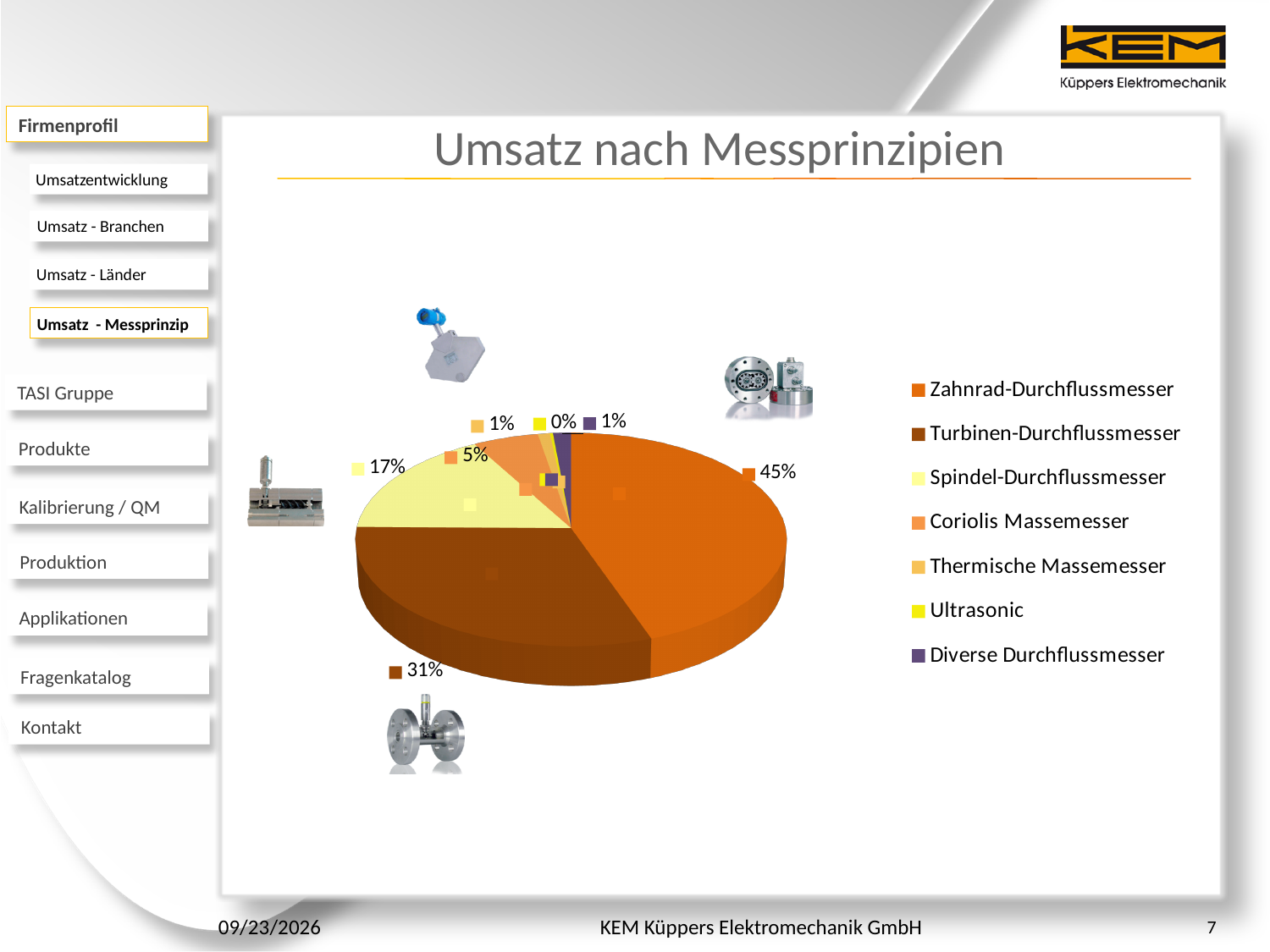
What kind of chart is shown on the slide? pie chart What share of the pie does Turbinen-Durchflussmesser have? 31% How many categories does the legend of the pie chart list? 7 What share of the pie does Coriolis Massemesser have? 5% Which category has the smallest share of the pie? Ultrasonic Which has a larger share, Spindel-Durchflussmesser or Coriolis Massemesser? Spindel-Durchflussmesser What is the title of the chart? Umsatz nach Messprinzipien Which category has the largest share of the pie? Zahnrad-Durchflussmesser What share of the pie does Ultrasonic have? 0% What is the difference in percentage points between the Zahnrad-Durchflussmesser share and the Turbinen-Durchflussmesser share? 14 percentage points